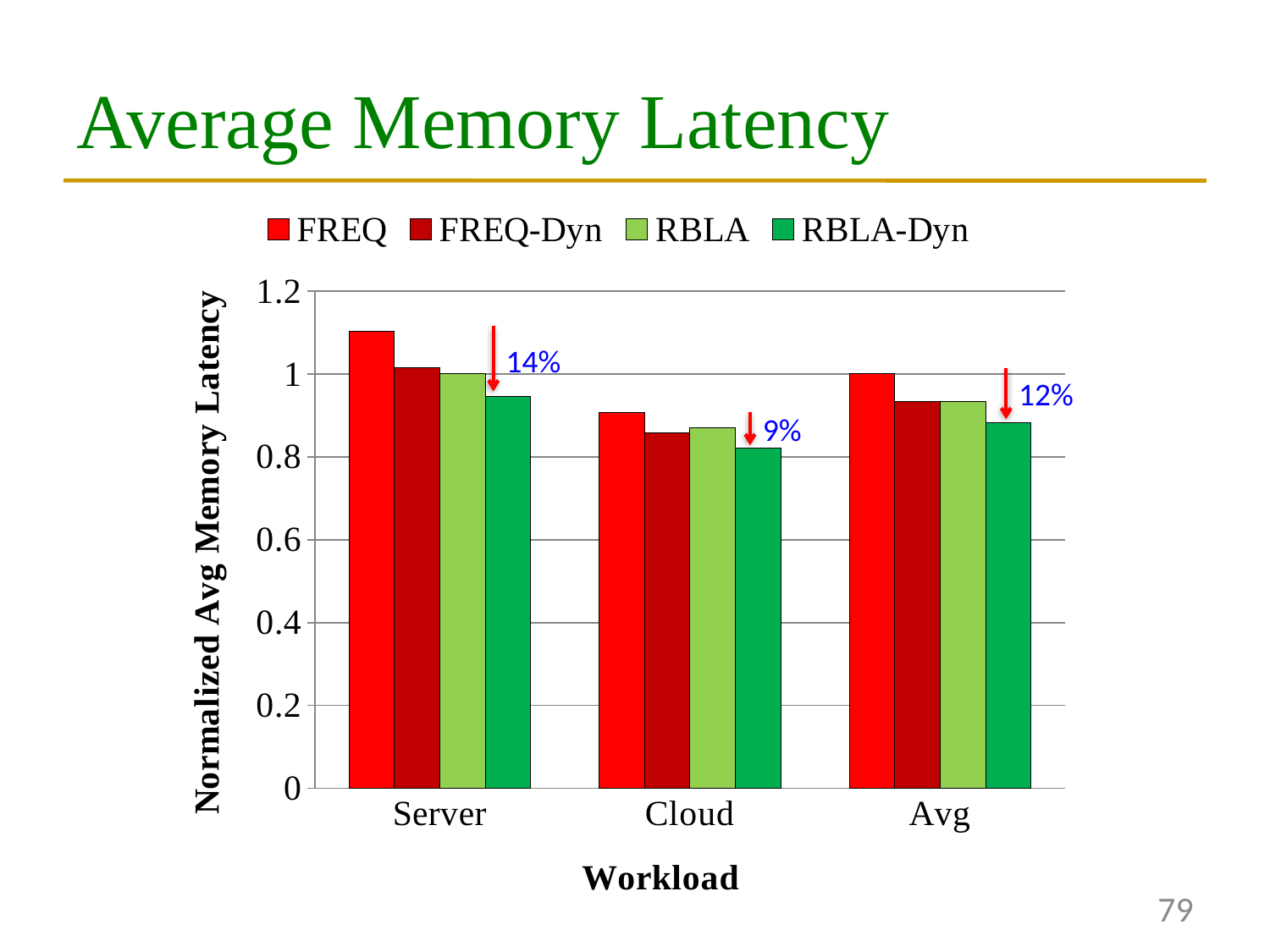
Is the FREQ value for Server greater or less than 1? greater What is the title of the y axis? Normalized Avg Memory Latency What percentage reduction is annotated above the RBLA-Dyn bar for the Server workload? 14% How many workload categories are shown on the x axis? 3 Which series has the lowest value for the Cloud workload? RBLA-Dyn Which series has the highest value for the Server workload? FREQ What kind of chart is shown on the slide? bar chart What percentage reduction is annotated for the Cloud workload? 9% How many series does the legend list? 4 Is the FREQ value for Cloud greater or less than 1? less What percentage reduction is annotated for the Avg workload? 12%